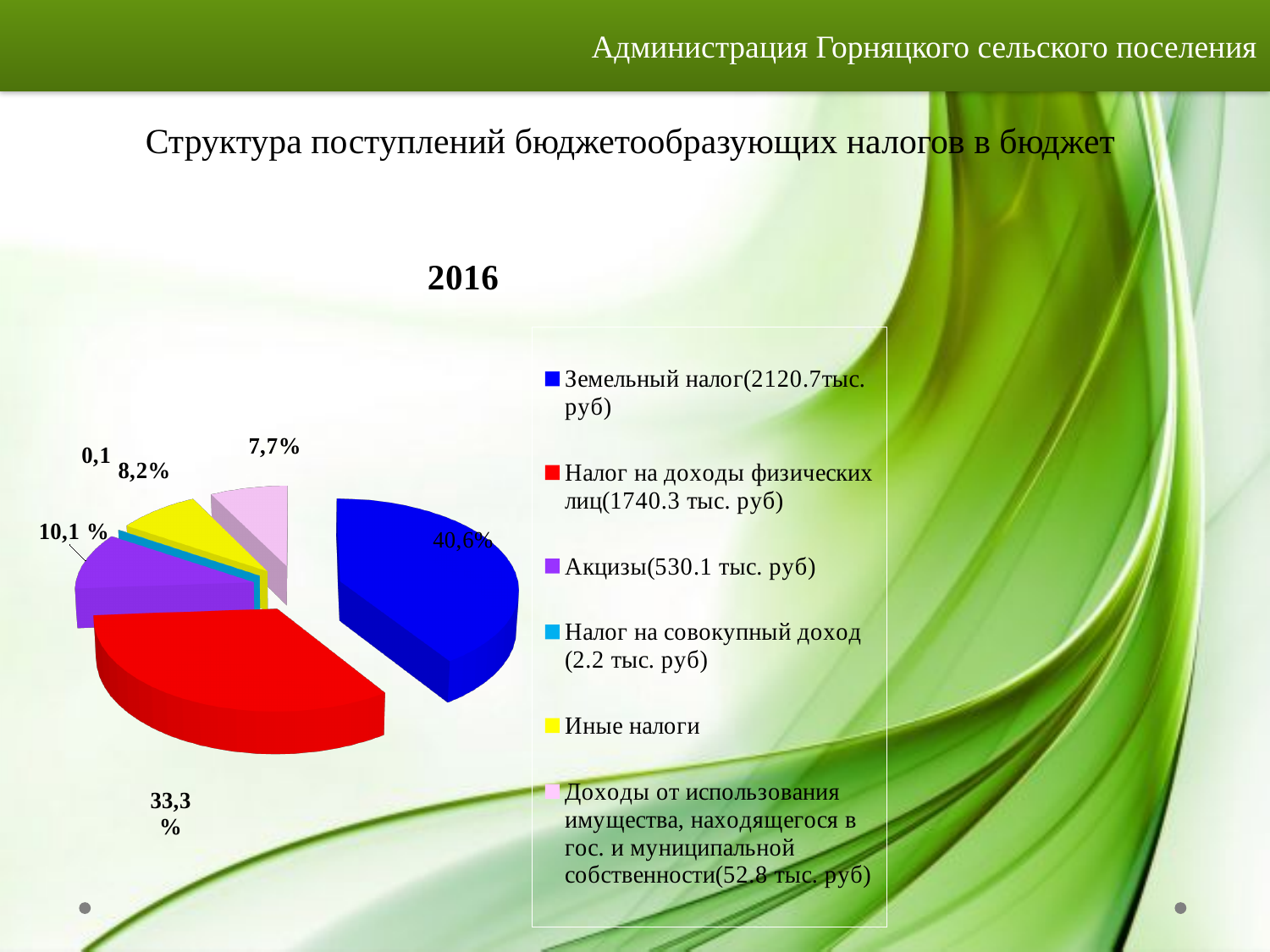
How many entries does the legend of the pie chart list? 6 By how many percentage points does the share of Земельный налог exceed the share of Налог на доходы физических лиц? 7,3 Which category has the largest slice of the pie? Земельный налог(2120.7тыс. руб) Which category has the smallest slice of the pie? Налог на совокупный доход (2.2 тыс. руб) What type of chart is shown on the slide? Pie chart What share of the pie does Доходы от использования имущества, находящегося в гос. и муниципальной собственности (52.8 тыс. руб) have? 7,7% What share of the pie does Земельный налог (2120.7 тыс. руб) have? 40,6% What share of the pie does Акцизы (530.1 тыс. руб) have? 10,1 % What is the title shown above the pie chart? 2016 What share of the pie does Налог на доходы физических лиц (1740.3 тыс. руб) have? 33,3 % Which is larger: the share of Иные налоги or the share of Доходы от использования имущества? Иные налоги What share of the pie does Иные налоги have? 8,2%